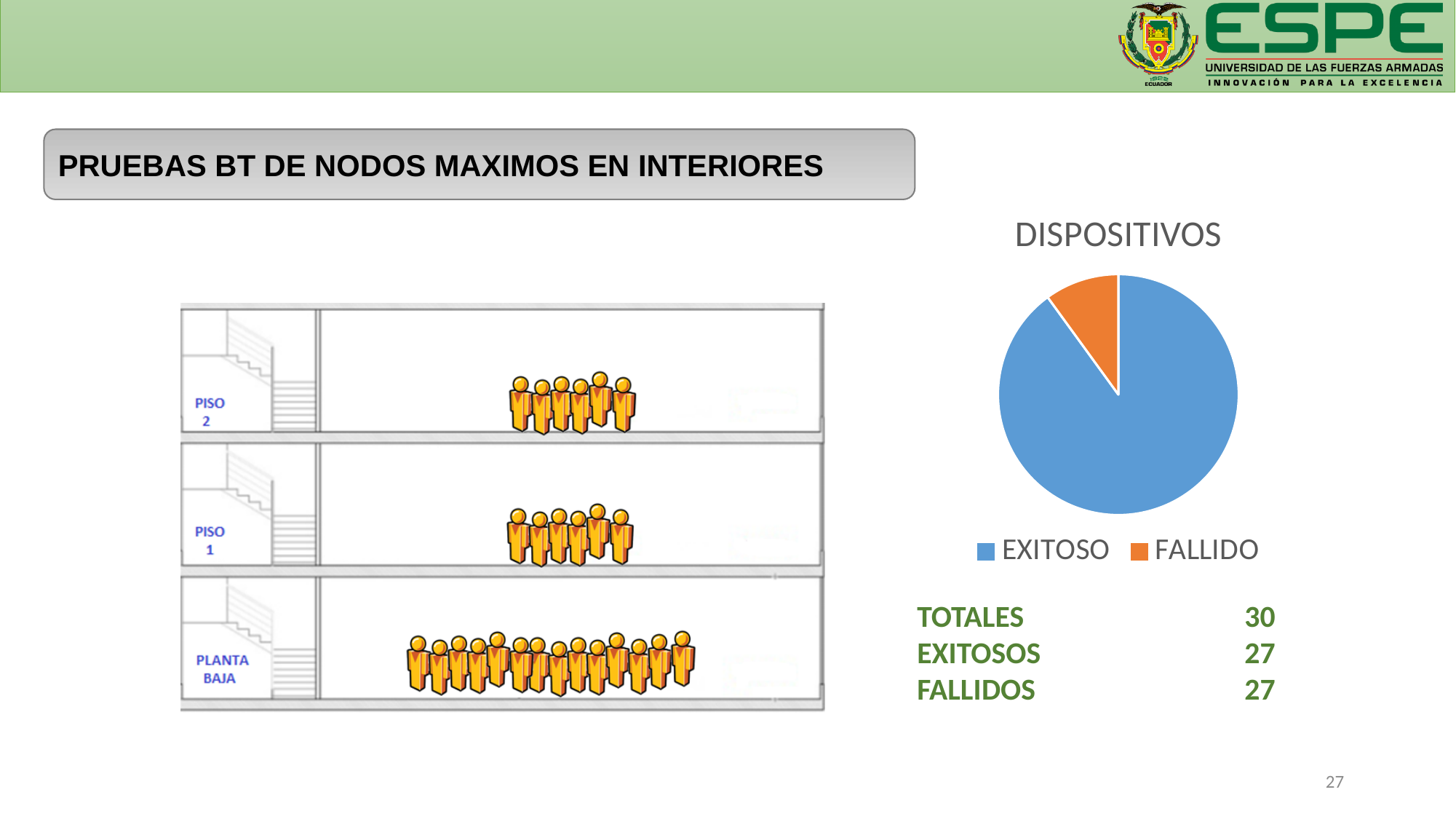
Which category in the DISPOSITIVOS pie chart is shown in orange? FALLIDO What colour is the EXITOSO slice in the DISPOSITIVOS pie chart? Blue What is the title of the pie chart? DISPOSITIVOS Which category has the smallest slice in the DISPOSITIVOS pie chart? FALLIDO How many entries does the legend of the DISPOSITIVOS pie chart list? 2 Which category has the largest slice in the DISPOSITIVOS pie chart? EXITOSO In the DISPOSITIVOS pie chart, which slice is larger, EXITOSO or FALLIDO? EXITOSO How many slices does the DISPOSITIVOS pie chart have? 2 What kind of chart is shown under the title DISPOSITIVOS? Pie chart